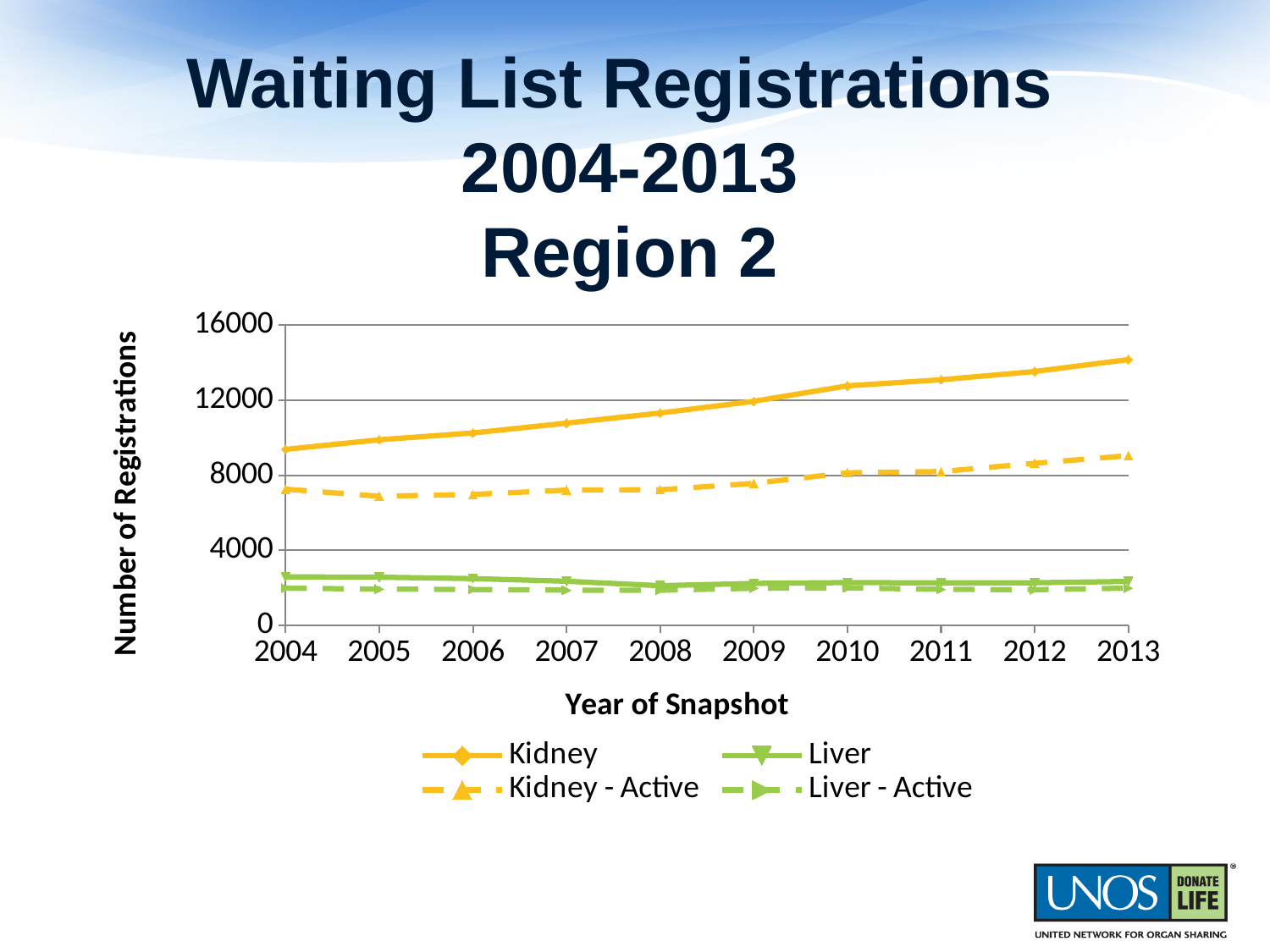
In which year is the Kidney series at its highest? 2013 In which year is the Kidney series at its lowest? 2004 Is the value for Kidney - Active in 2005 greater or less than 8000? less Is the value for Kidney in 2013 greater or less than 12000? greater Which series has the larger value in 2010, Kidney or Liver? Kidney Is the value for Liver in 2004 greater or less than 4000? less Does the Kidney series rise or fall from 2004 to 2013? rise How many years are plotted along the x axis? 10 What is the title of the x axis? Year of Snapshot What kind of chart is shown on the slide? line chart How many series does the legend list? 4